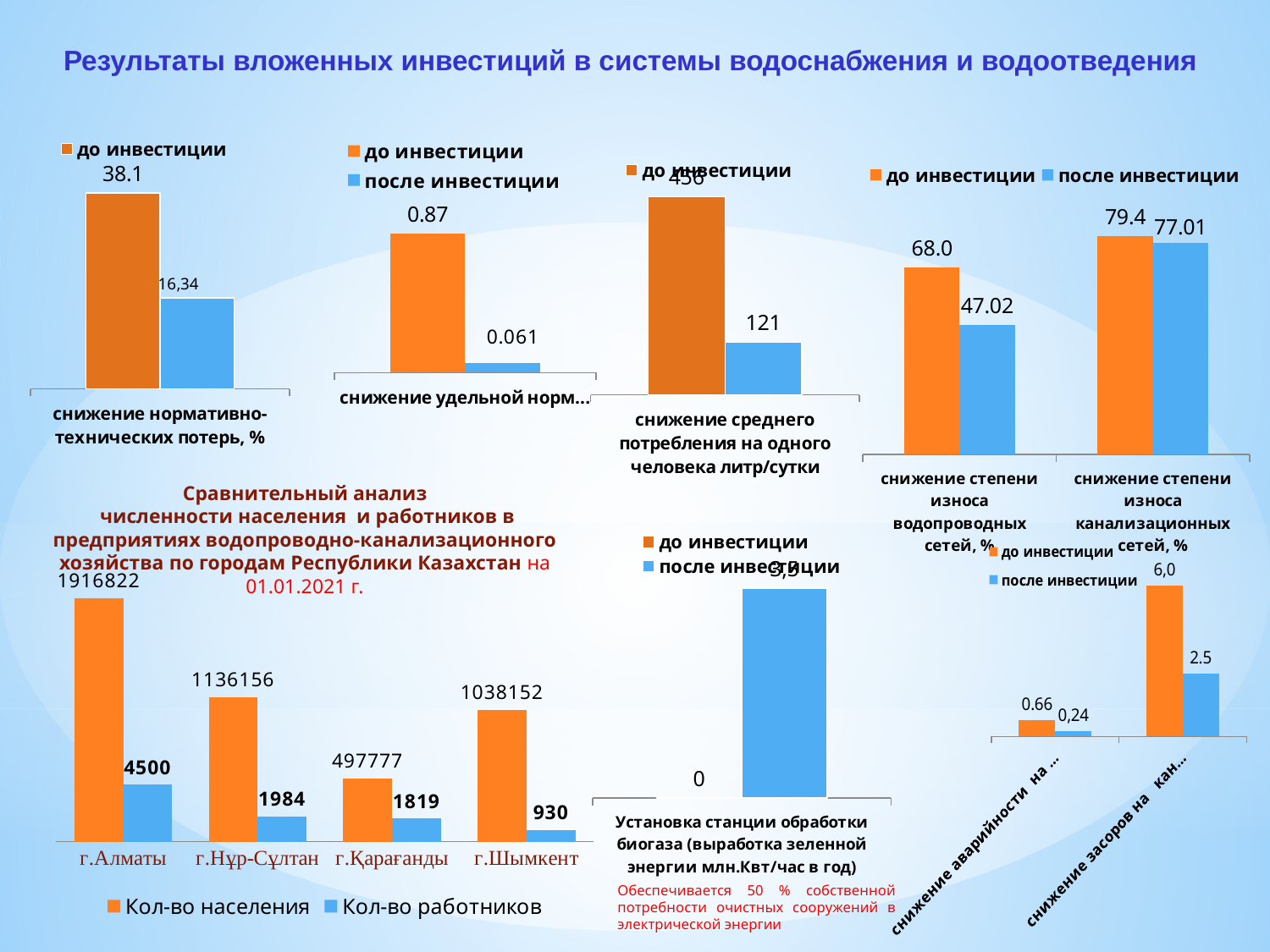
In the chart 'Сравнительный анализ численности населения и работников', which city has the lowest 'Кол-во работников'? г.Шымкент In the chart titled 'снижение среднего потребления на одного человека литр/сутки', what is the value for 'после инвестиции'? 121 In the chart 'Сравнительный анализ численности населения и работников', which city has the highest 'Кол-во населения'? г.Алматы In the chart titled 'снижение нормативно-технических потерь, %', what is the value for 'после инвестиции'? 16,34 In the chart with the categories 'снижение степени износа водопроводных сетей, %' and 'снижение степени износа канализационных сетей, %', what is the difference between the 'до инвестиции' and 'после инвестиции' values for канализационных сетей? 2.39 In the bottom-right chart, what is the 'до инвестиции' value for 'снижение аварийности на ...'? 0.66 In the chart titled 'снижение нормативно-технических потерь, %', what is the value for 'до инвестиции'? 38.1 In the chart 'Сравнительный анализ численности населения и работников', how many cities are shown on the x axis? 4 In the chart 'Сравнительный анализ численности населения и работников', what is the 'Кол-во населения' for г.Қарағанды? 497777 What kind of chart is the chart titled 'снижение удельной норм...'? bar chart In the chart with the categories 'снижение степени износа водопроводных сетей, %' and 'снижение степени износа канализационных сетей, %', what is the 'после инвестиции' value for водопроводных сетей? 47.02 In the chart 'Сравнительный анализ численности населения и работников', which is larger: 'Кол-во работников' for г.Нұр-Сұлтан or for г.Қарағанды? г.Нұр-Сұлтан